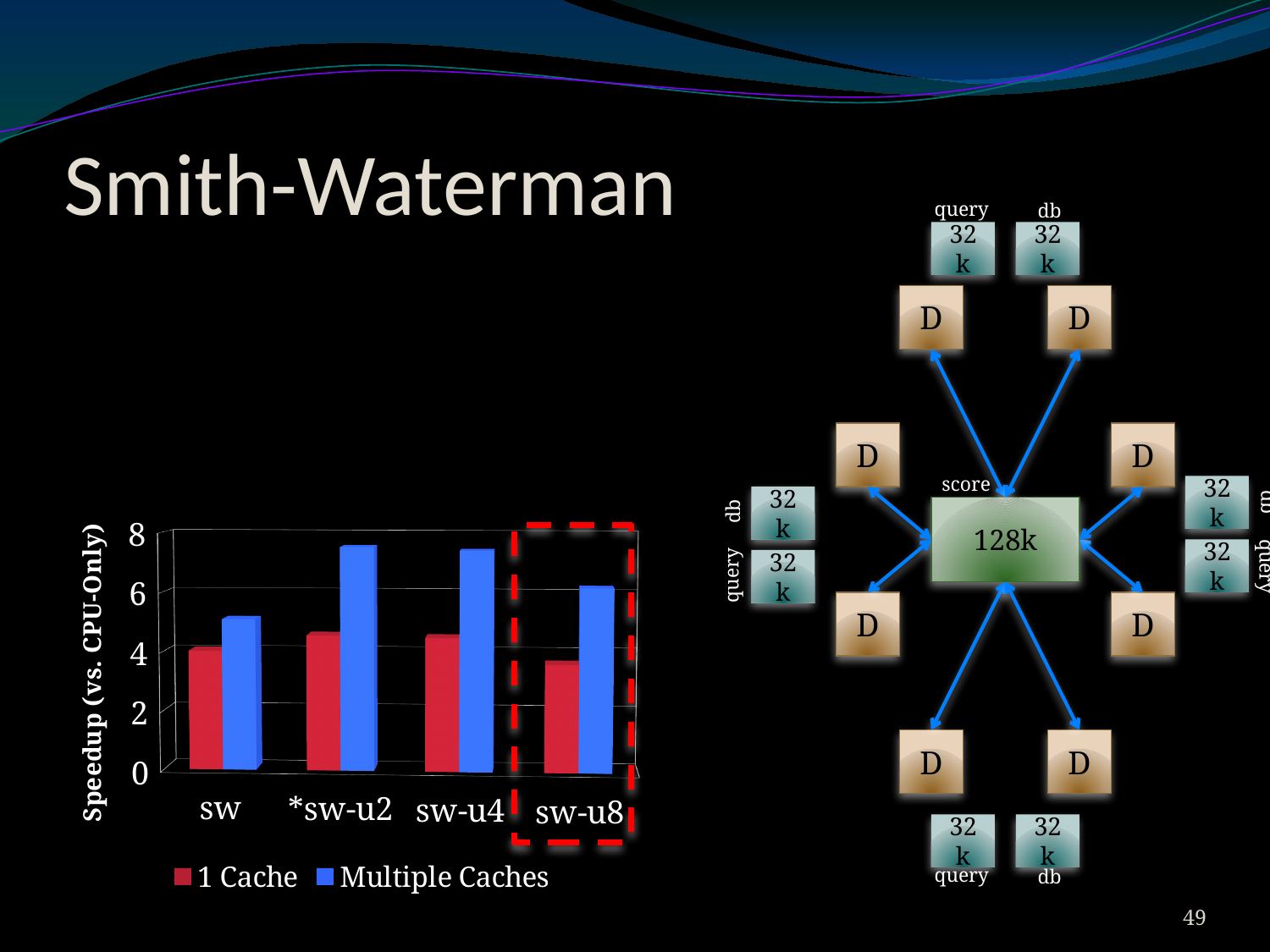
Which category has the lowest Multiple Caches value? sw Is the Multiple Caches value for sw-u4 greater or less than 6? greater For sw-u8, which series has the larger value, 1 Cache or Multiple Caches? Multiple Caches Is the Multiple Caches value for *sw-u2 greater or less than 6? greater Which category on the bar chart is enclosed by the red dashed box? sw-u8 Is the Multiple Caches value for sw greater or less than 6? less Which category has the lowest 1 Cache value? sw-u8 How many series does the legend of the bar chart list? 2 What kind of chart is shown on the slide? bar chart How many categories are shown on the x axis of the bar chart? 4 What is the title of the y axis of the bar chart? Speedup (vs. CPU-Only)